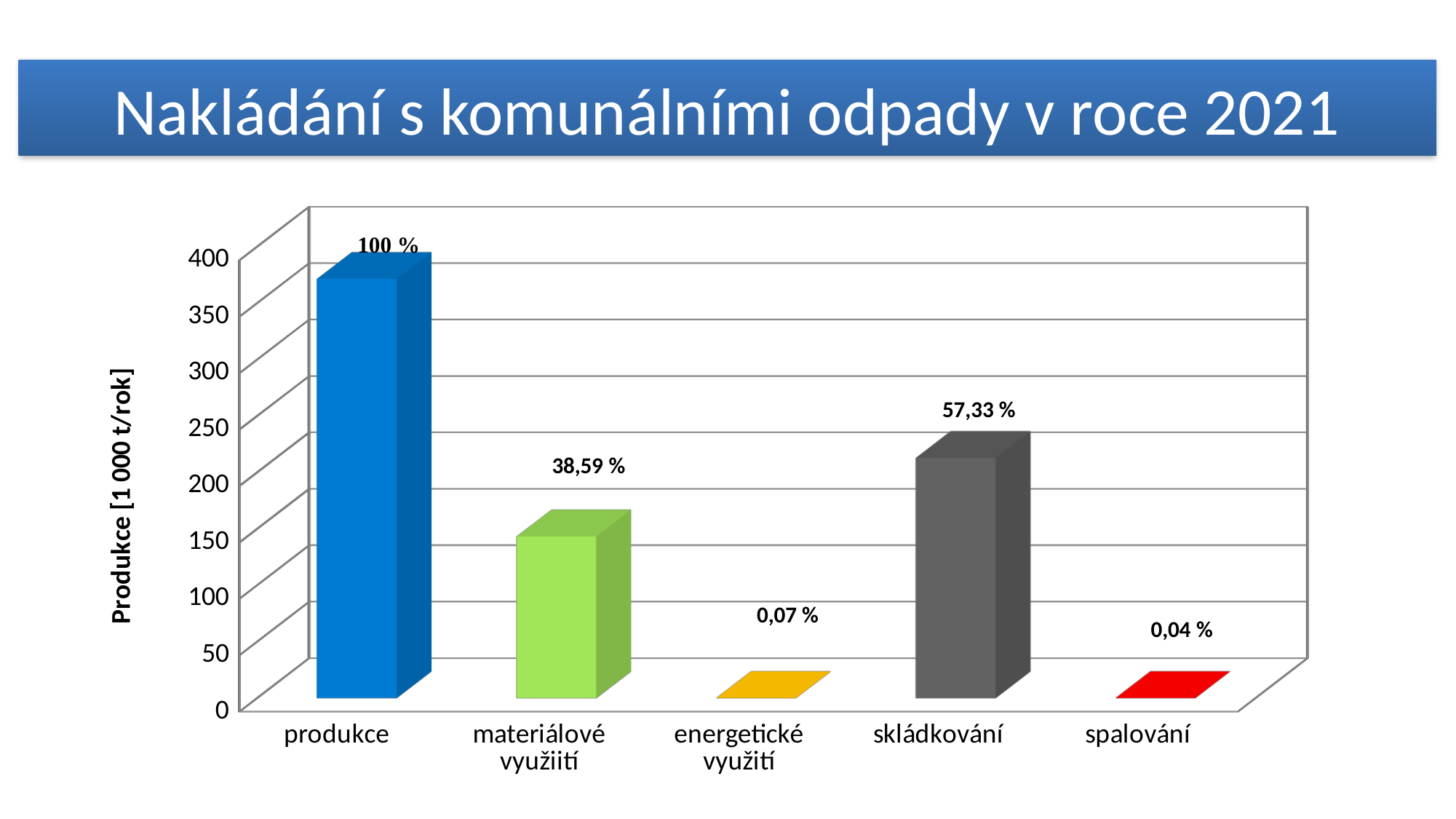
What is the data label shown above the bar for materiálové využiití? 38,59 % What is the data label shown above the bar for produkce? 100 % Is the value for produkce greater or less than 300? greater What is the data label shown above the bar for energetické využití? 0,07 % What is the data label shown above the bar for skládkování? 57,33 % What is the data label shown above the bar for spalování? 0,04 % Is the value for materiálové využiití greater or less than 200? less Which category has the lowest value according to the data labels? spalování Which category has the highest bar? produkce What is the label of the vertical axis? Produkce [1 000 t/rok] How many categories are shown on the x axis? 5 Which is larger, the bar for skládkování or the bar for materiálové využiití? skládkování